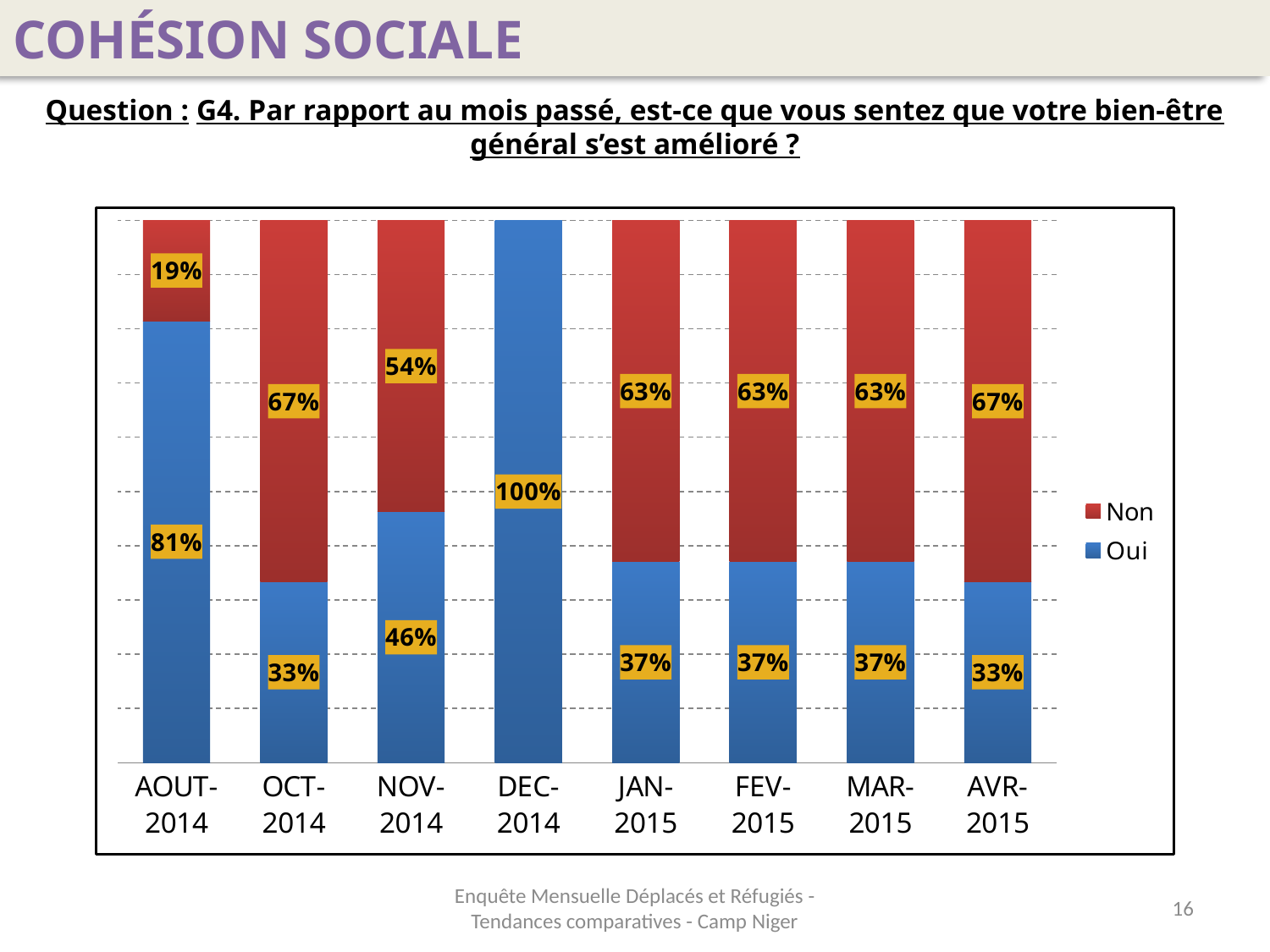
What kind of chart is shown on the slide? Stacked bar chart In which month is the Oui value highest? DEC-2014 What is the difference between the Non value and the Oui value in OCT-2014? 34% How many months are shown on the x axis? 8 What is the value for Non in NOV-2014? 54% How many series does the legend list? 2 In which month is the Non value lowest? DEC-2014 Which colour represents the Oui series in the legend? Blue What is the value for Non in AVR-2015? 67% What is the value for Oui in DEC-2014? 100% What is the value for Oui in AOUT-2014? 81% Which is larger in NOV-2014, the Oui value or the Non value? Non